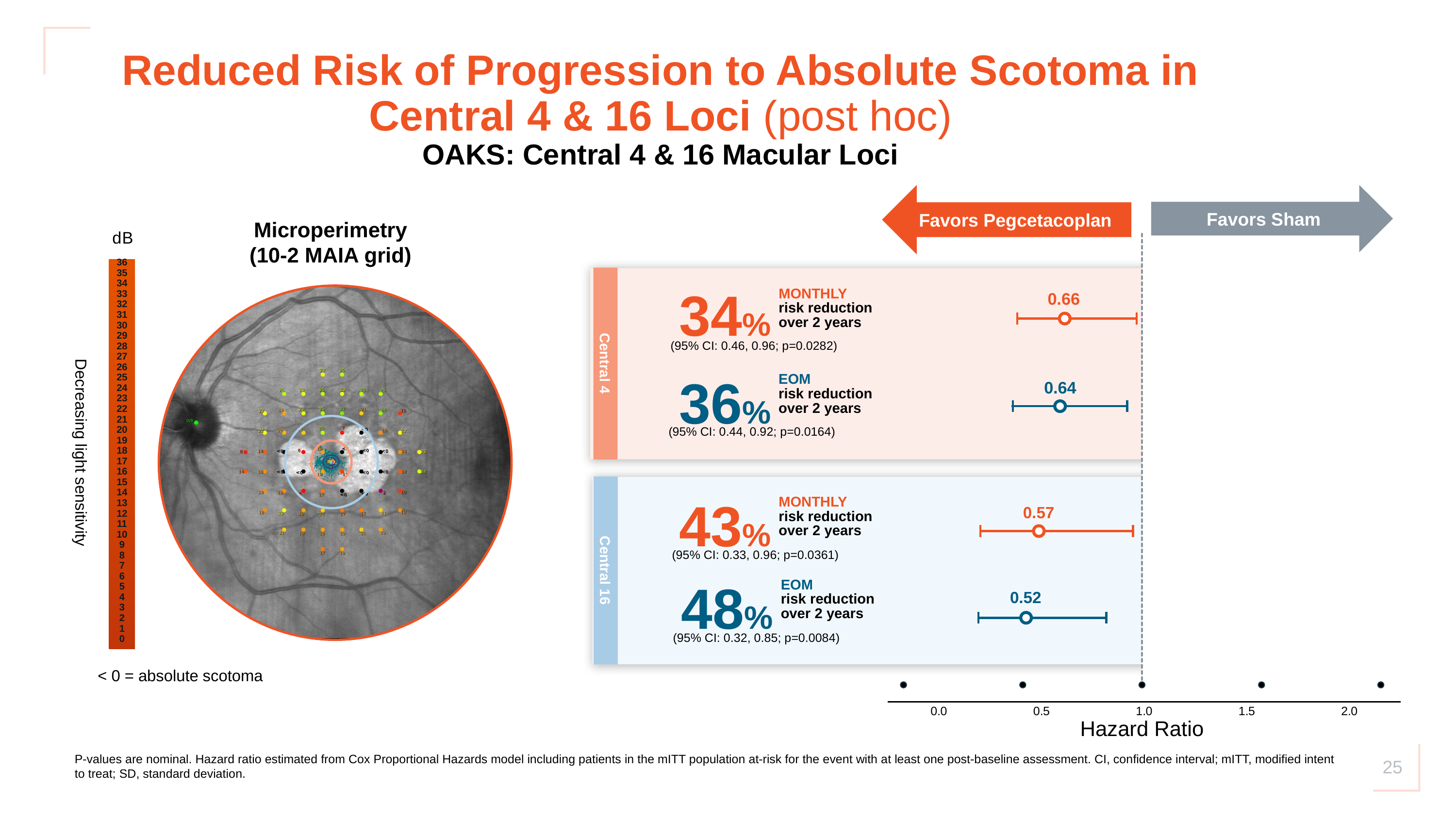
In the hazard ratio forest plot, which group has the lowest hazard ratio? Central 16 EOM In the hazard ratio forest plot, what is the difference between the Central 4 Monthly hazard ratio and the Central 16 EOM hazard ratio? 0.14 What is the risk reduction over 2 years shown for the Central 4 Monthly group? 34% What is the label of the horizontal axis in the forest plot? Hazard Ratio In the hazard ratio forest plot, how many hazard ratio point estimates are plotted? 4 In the hazard ratio forest plot, what is the hazard ratio for the Central 16 Monthly group? 0.57 In the hazard ratio forest plot, which is larger: the hazard ratio for Central 16 Monthly or for Central 16 EOM? Central 16 Monthly In the hazard ratio forest plot, which group has the highest hazard ratio? Central 4 Monthly In the hazard ratio forest plot, what is the hazard ratio for the Central 4 Monthly group? 0.66 What is the risk reduction over 2 years shown for the Central 16 EOM group? 48% In the hazard ratio forest plot, what is the hazard ratio for the Central 16 EOM group? 0.52 In the hazard ratio forest plot, what is the hazard ratio for the Central 4 EOM group? 0.64